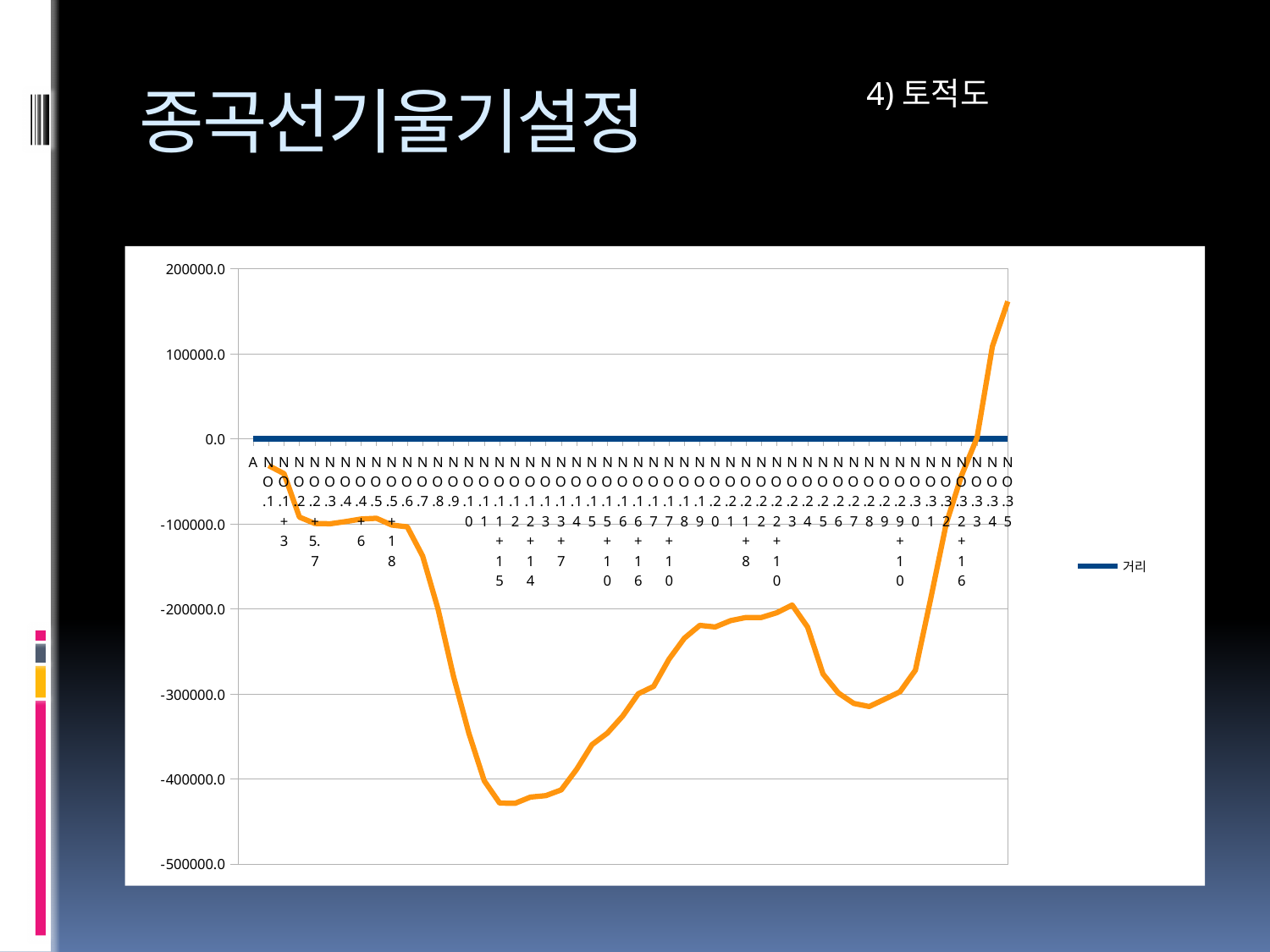
What is the highest value shown on the chart's y axis? 200000.0 Which series is higher at the rightmost point of the chart, the orange line or the blue '거리' line? the orange line Does the orange line end higher or lower than it starts? higher What value does the flat blue '거리' line sit at on the y axis? 0.0 Is the value of the orange line at its first (leftmost) point greater or less than -100000.0? greater What kind of chart is shown on the slide? line chart Is the lowest point of the orange line greater or less than -400000.0? less How many series does the chart's legend list? 1 What is the name of the series listed in the chart's legend? 거리 Is the value of the orange line at its final (rightmost) point greater or less than 100000.0? greater